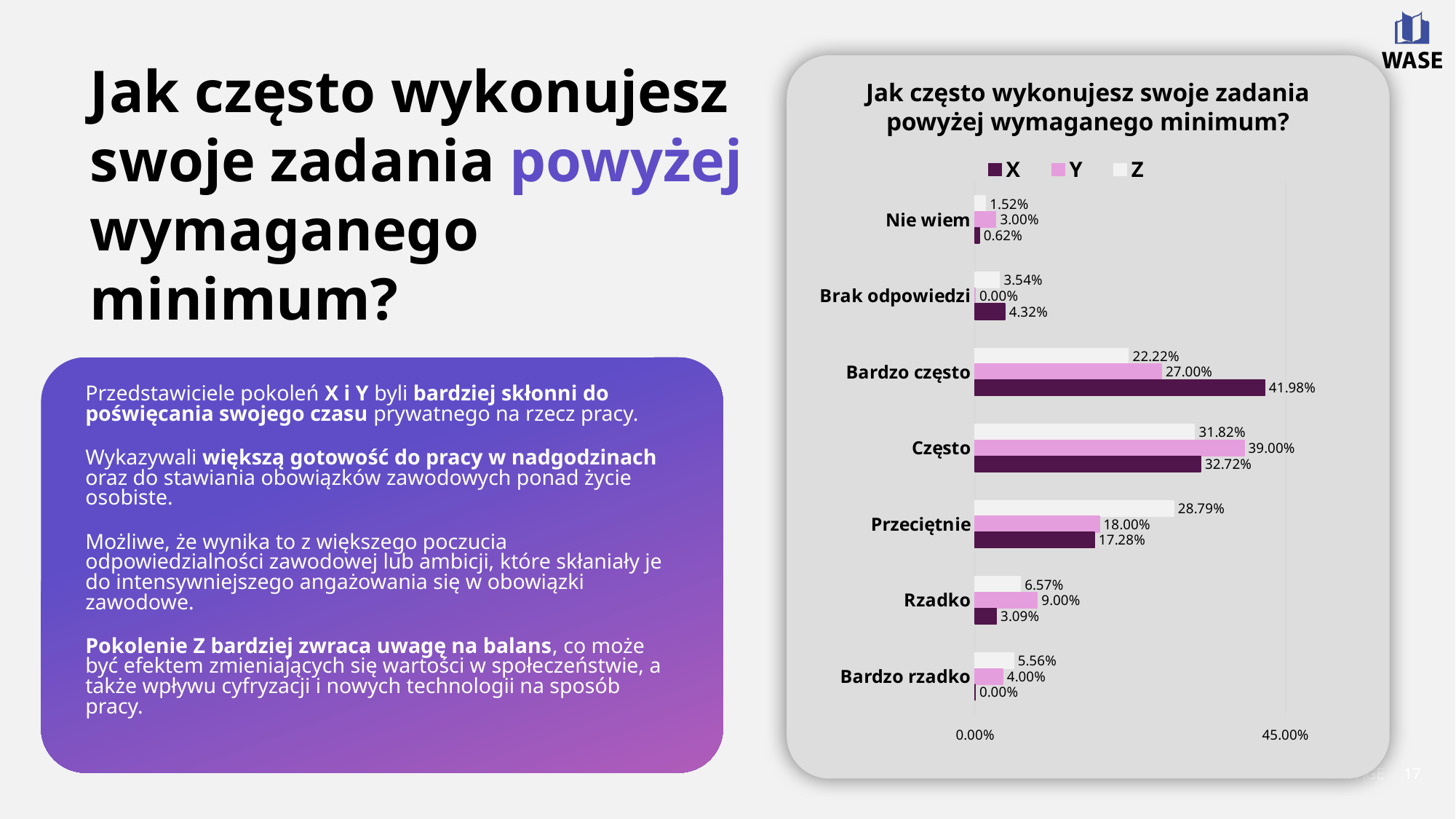
What is the title of the chart? Jak często wykonujesz swoje zadania powyżej wymaganego minimum? What is the value for series X in the category "Bardzo często"? 41.98% In the category "Przeciętnie", which series has the larger value, Y or Z? Z What is the value for series Y in the category "Brak odpowiedzi"? 0.00% How many categories are shown on the chart? 7 What is the value for series Y in the category "Często"? 39.00% Which category has the highest value for series X? Bardzo często How many series does the chart legend list? 3 Which category has the lowest value for series Z? Nie wiem What is the difference between the X and Y values in the category "Bardzo często"? 14.98% What is the value for series Z in the category "Przeciętnie"? 28.79% What kind of chart is shown on the slide? Bar chart